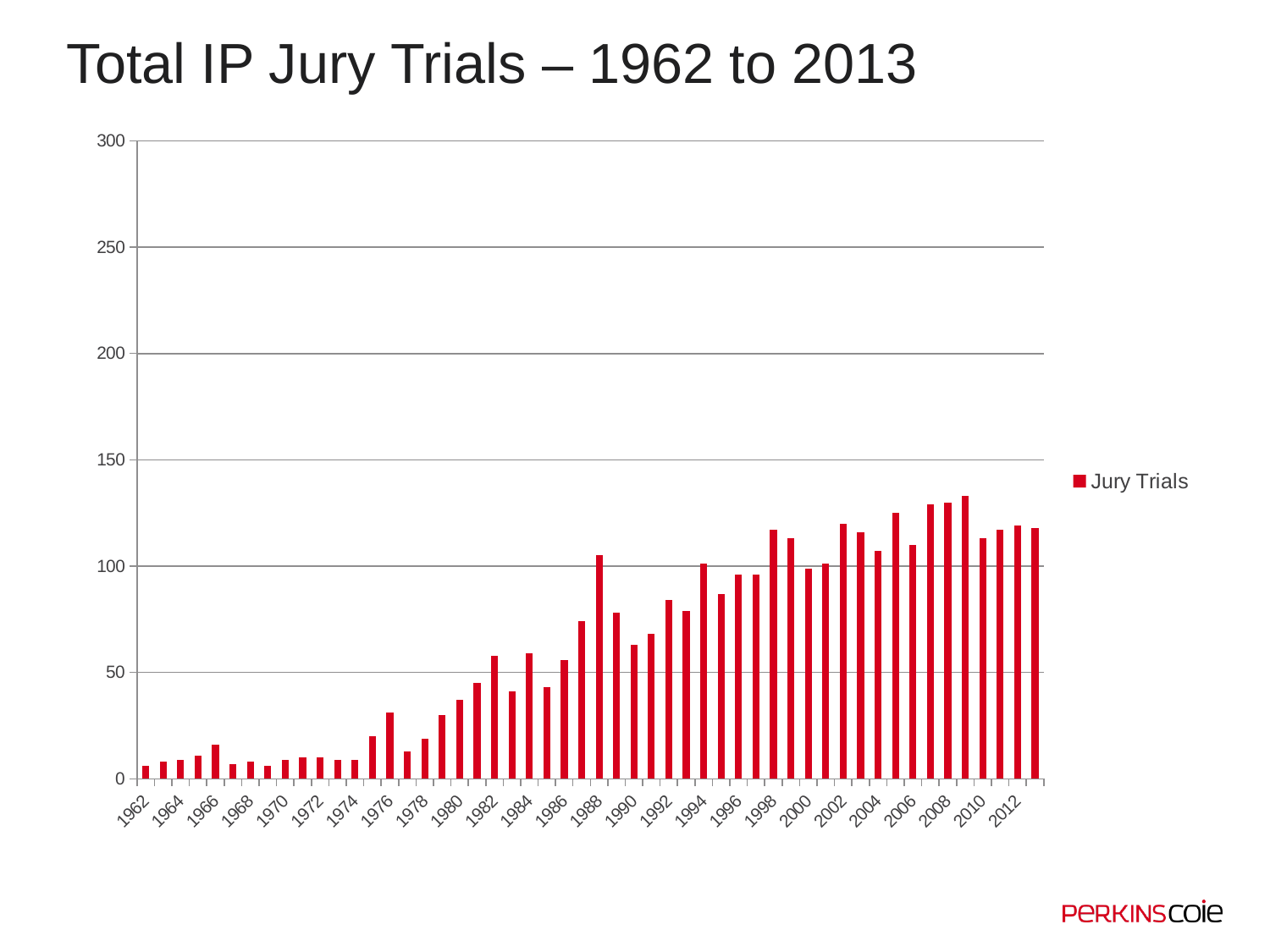
Is the value for 2009 greater or less than 150? less Is the value for 1976 greater or less than 50? less How many series does the legend list? 1 Which year has the larger value, 2002 or 2004? 2002 What is the name of the series shown in the legend? Jury Trials Which year has the larger value, 1988 or 1990? 1988 Overall, do the values rise or fall from 1962 to 2013? rise What is the title of the chart on the slide? Total IP Jury Trials – 1962 to 2013 What kind of chart is shown on the slide? bar chart Is the value for 1988 greater or less than 100? greater Which year has the larger value, 1976 or 1978? 1976